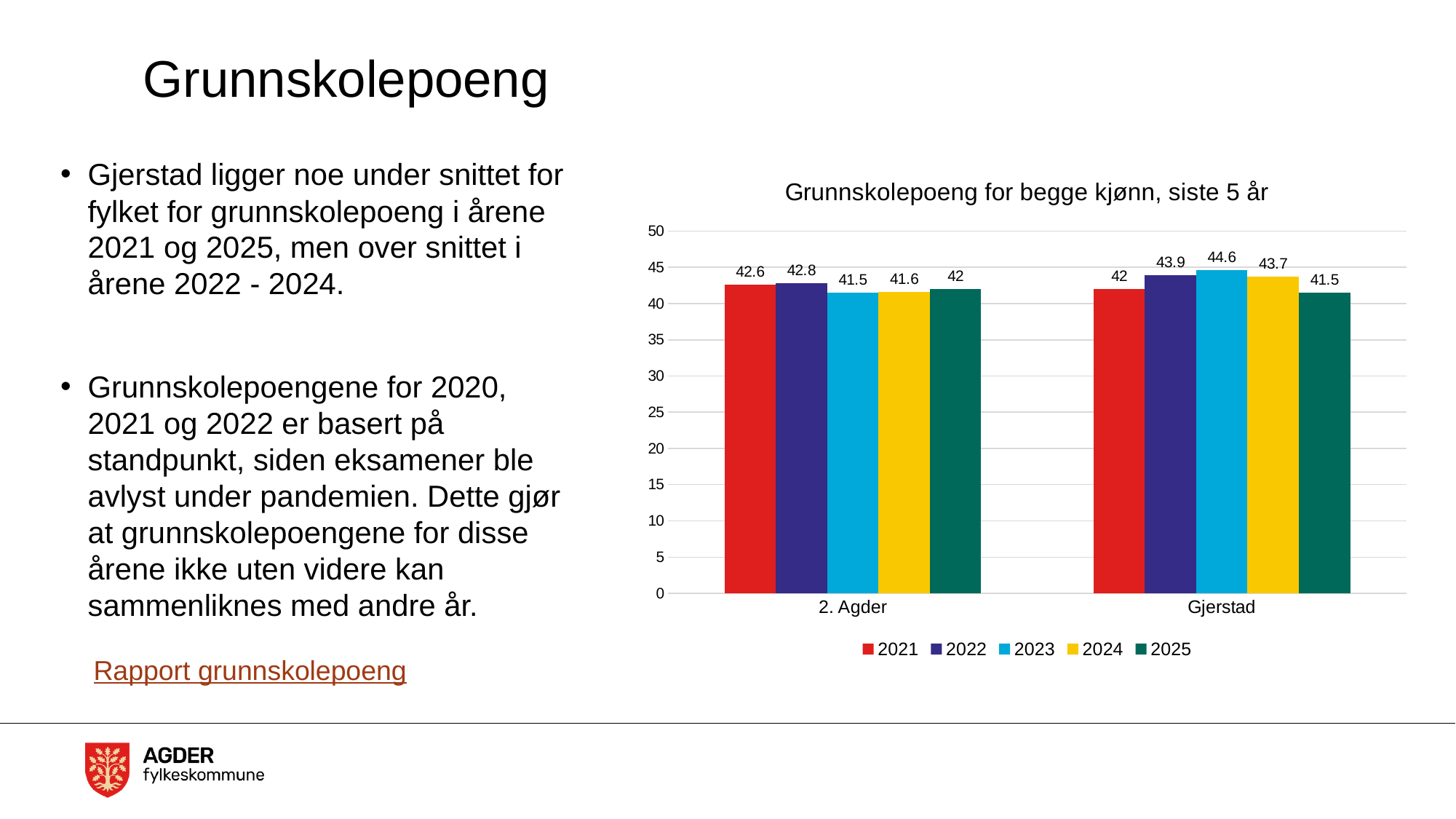
What is the difference between the 2023 values for Gjerstad and 2. Agder? 3.1 Which year has the lowest value for 2. Agder? 2023 What is the value for 2025 for Gjerstad? 41.5 Which year has the highest value for Gjerstad? 2023 How many categories are shown on the x axis? 2 What is the title of the chart? Grunnskolepoeng for begge kjønn, siste 5 år What kind of chart is shown? bar chart Which is larger, the 2022 value for 2. Agder or the 2022 value for Gjerstad? Gjerstad How many series does the legend list? 5 What is the value for 2021 for 2. Agder? 42.6 Is the value for 2024 for Gjerstad greater or less than 40? greater What is the value for 2023 for Gjerstad? 44.6